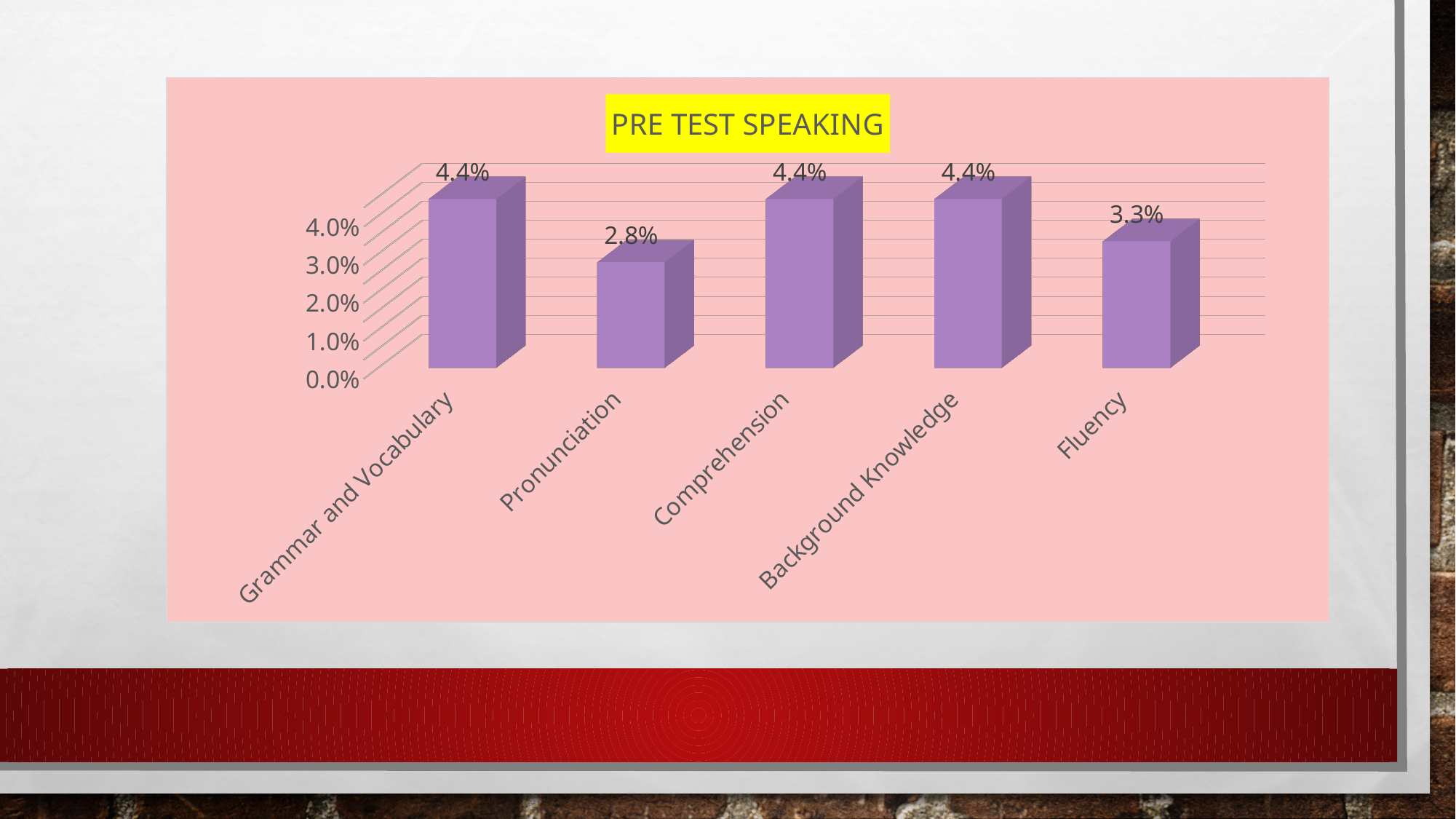
What is the title of the chart? PRE TEST SPEAKING What is the value for Grammar and Vocabulary? 4.4% What kind of chart is shown on the slide? bar chart Is the value for Pronunciation greater or less than 3.0%? less What is the difference between the values for Fluency and Pronunciation? 0.5% What is the value for Comprehension? 4.4% How many categories are shown on the chart? 5 What is the value for Pronunciation? 2.8% What is the value for Fluency? 3.3% Which category has the lowest value? Pronunciation What is the difference between the values for Background Knowledge and Pronunciation? 1.6% Which is larger, the value for Fluency or the value for Pronunciation? Fluency